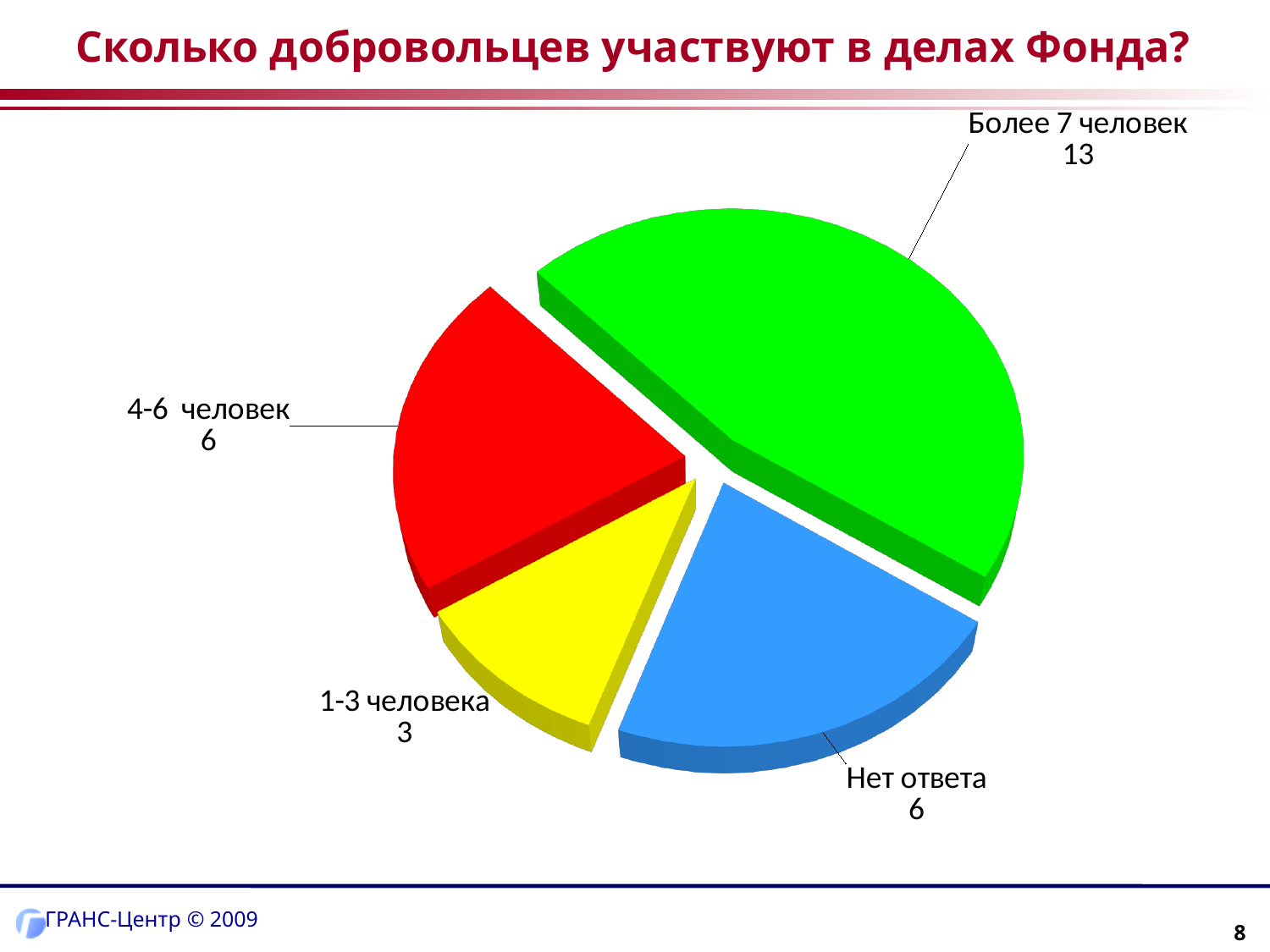
What is the difference between the values for "Более 7 человек" and "4-6 человек"? 7 What is the value for "Нет ответа"? 6 What is the value for "1-3 человека"? 3 Which category has the smallest slice? 1-3 человека What is the value for "Более 7 человек"? 13 What type of chart is shown on the slide? Pie chart Which is larger, the value for "Нет ответа" or the value for "1-3 человека"? Нет ответа Which category has the largest slice? Более 7 человек What is the title of the slide containing the chart? Сколько добровольцев участвуют в делах Фонда? How many slices does the pie chart have? 4 What is the total of all the values shown in the pie chart? 28 What is the value for "4-6 человек"? 6